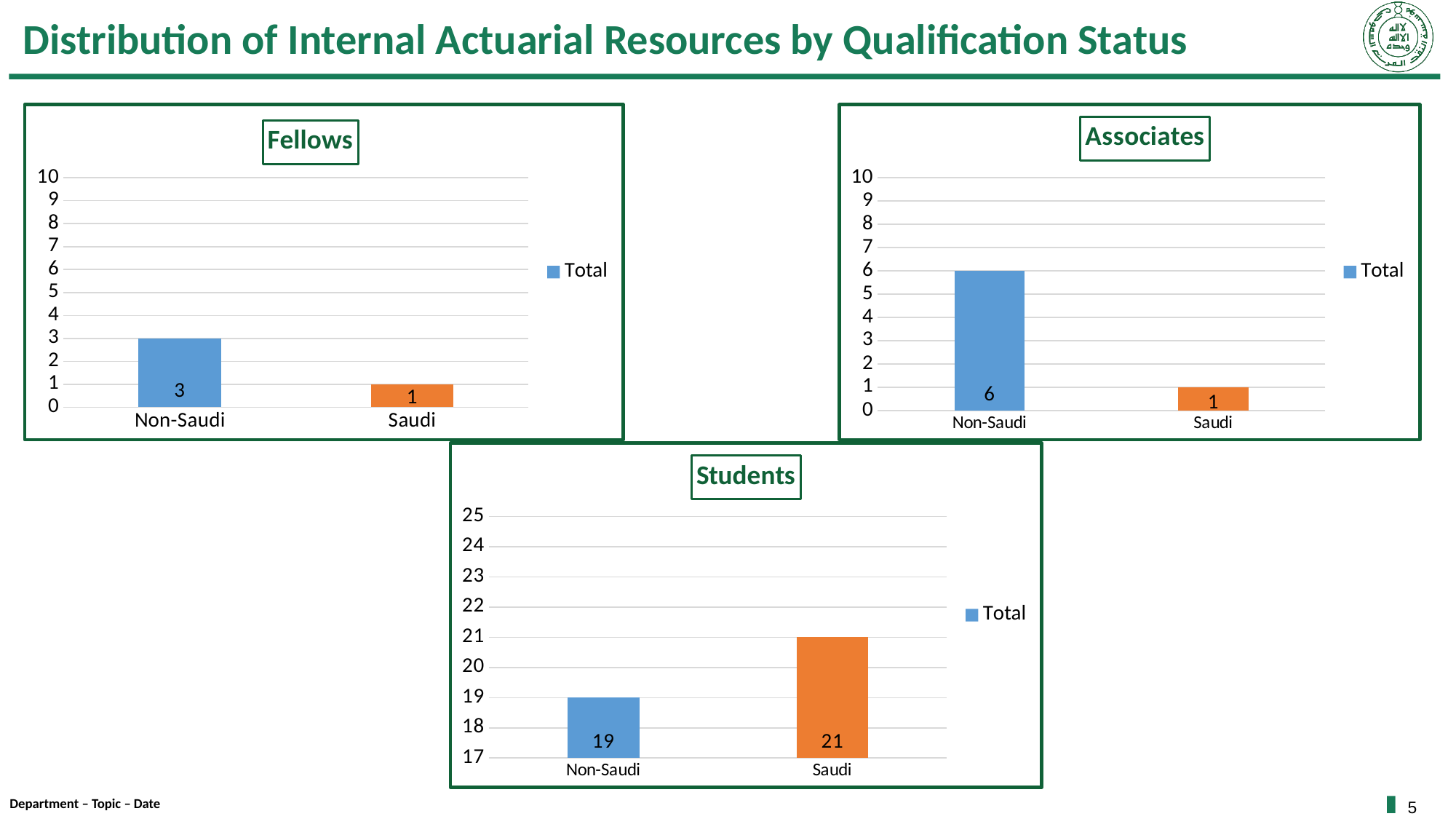
In the Associates chart, what is the value for Non-Saudi? 6 In the Fellows chart, what is the value for Saudi? 1 In the Associates chart, which category has the lowest value? Saudi In the Students chart, what is the difference between the Saudi and Non-Saudi values? 2 In the Students chart, what is the value for Saudi? 21 In the Associates chart, what is the difference between the Non-Saudi and Saudi values? 5 What kind of chart is the Associates chart? bar chart In the Students chart, which category has the highest value? Saudi What series name does the legend of the Fellows chart list? Total How many categories are shown in the Students chart? 2 In the Fellows chart, which is larger, Non-Saudi or Saudi? Non-Saudi In the Fellows chart, what is the value for Non-Saudi? 3